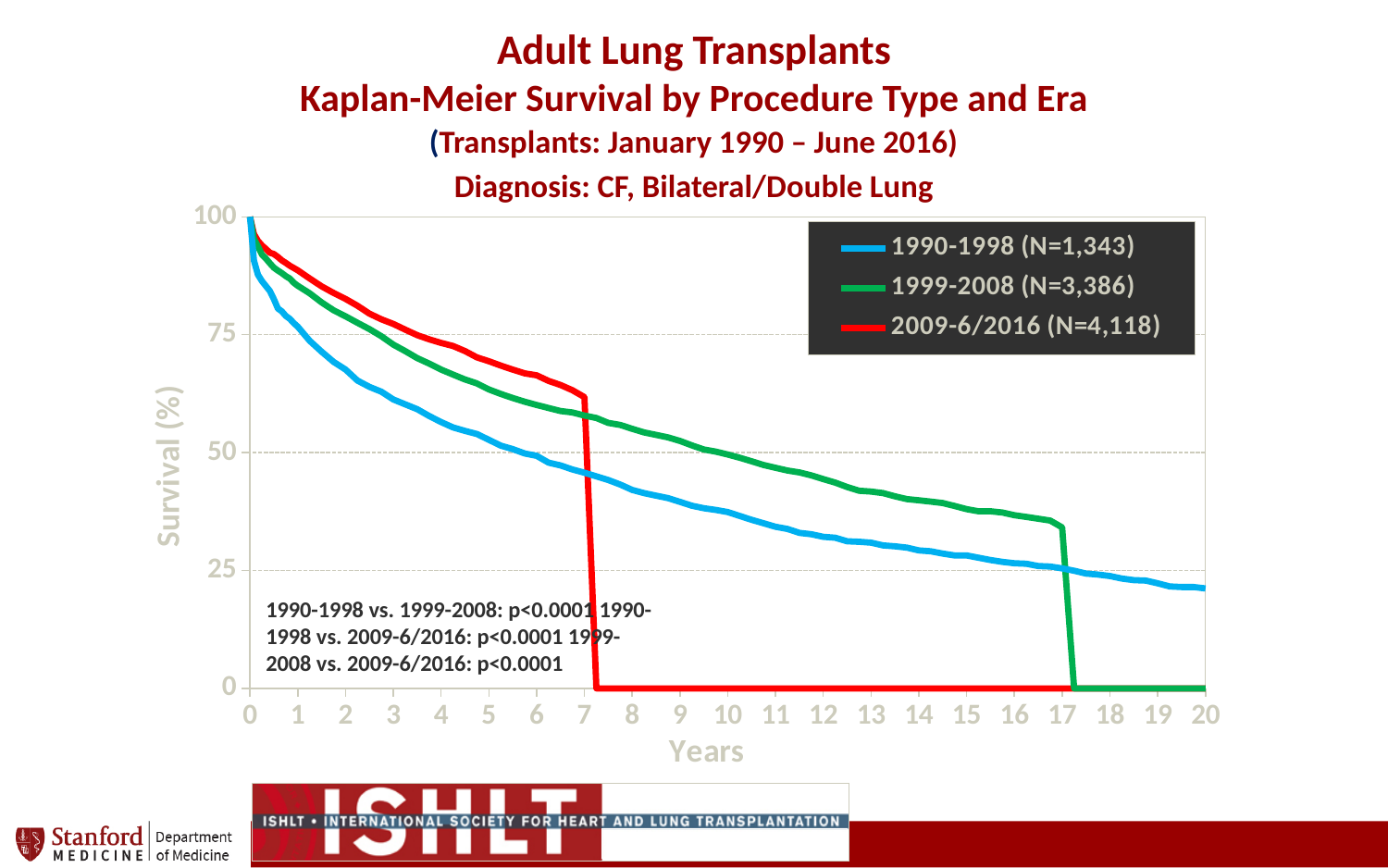
What is the N for the 1999-2008 era shown in the legend? 3,386 Is the survival for the 2009-6/2016 era at 5 years greater or less than 50? greater At 5 years, which era has higher survival: 1990-1998 or 2009-6/2016? 2009-6/2016 Which era has the lowest survival at 10 years? 1990-1998 What kind of chart is shown on the slide? line chart Do the survival curves rise or fall as years increase? fall Is the survival for the 1990-1998 era at 10 years greater or less than 50? less How many series does the legend list? 3 Is the survival for the 1999-2008 era at 15 years greater or less than 25? greater What is the N for the 2009-6/2016 era shown in the legend? 4,118 Which era has the highest survival at 3 years? 2009-6/2016 What is the N for the 1990-1998 era shown in the legend? 1,343